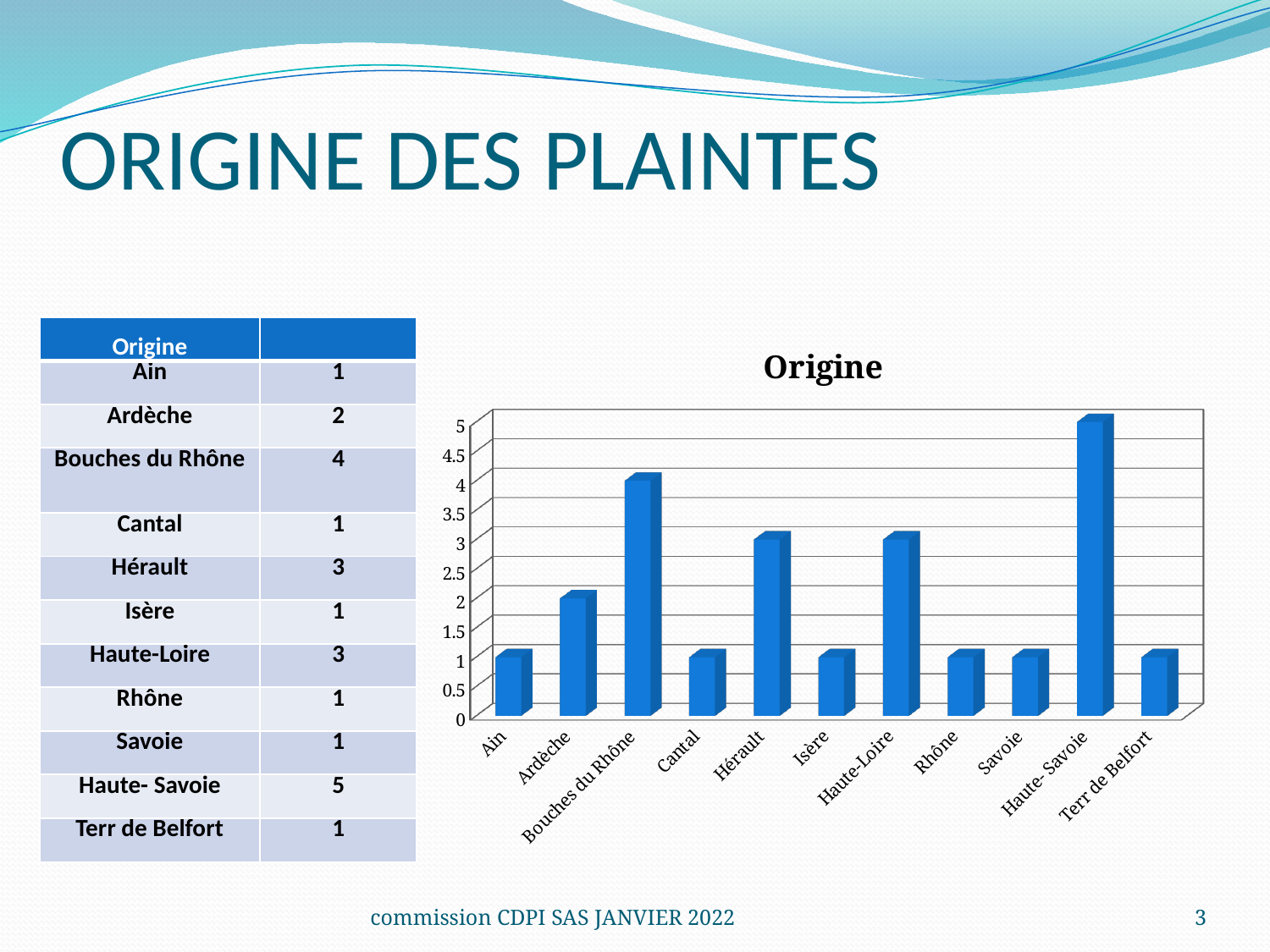
What type of chart is shown on the slide? bar chart Is the value for Bouches du Rhône greater or less than 3? greater What is the difference between the values for Haute- Savoie and Bouches du Rhône? 1 Which category has the highest value in the chart? Haute- Savoie How many categories are plotted on the x axis of the chart? 11 Which is larger, the value for Hérault or the value for Ardèche? Hérault What is the value for Hérault? 3 What is the value for Ardèche? 2 What is the value for Haute- Savoie? 5 How many categories have a value of 1? 6 What is the value for Bouches du Rhône? 4 What is the title of the chart? Origine